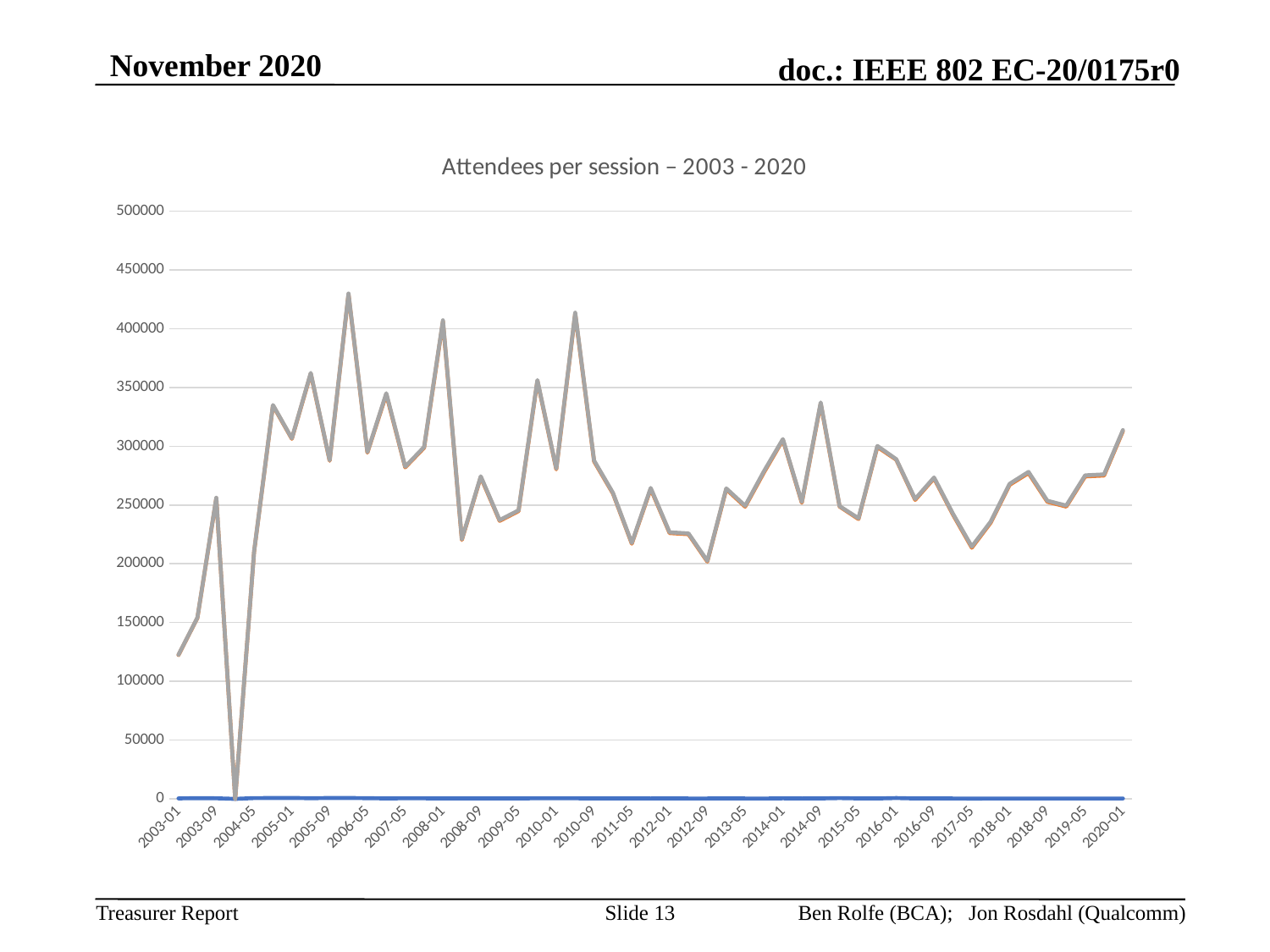
What kind of chart is shown on the slide? line chart Is the value for 2003-01 greater or less than 150000? less Is the value for 2014-09 greater or less than 300000? greater Do the values rise or fall from 2019-05 to 2020-01? rise Is the value for 2015-05 greater or less than 250000? less Which has the larger value, 2003-01 or 2020-01? 2020-01 Which has the larger value, 2008-01 or 2008-09? 2008-01 What is the title of the chart? Attendees per session – 2003 - 2020